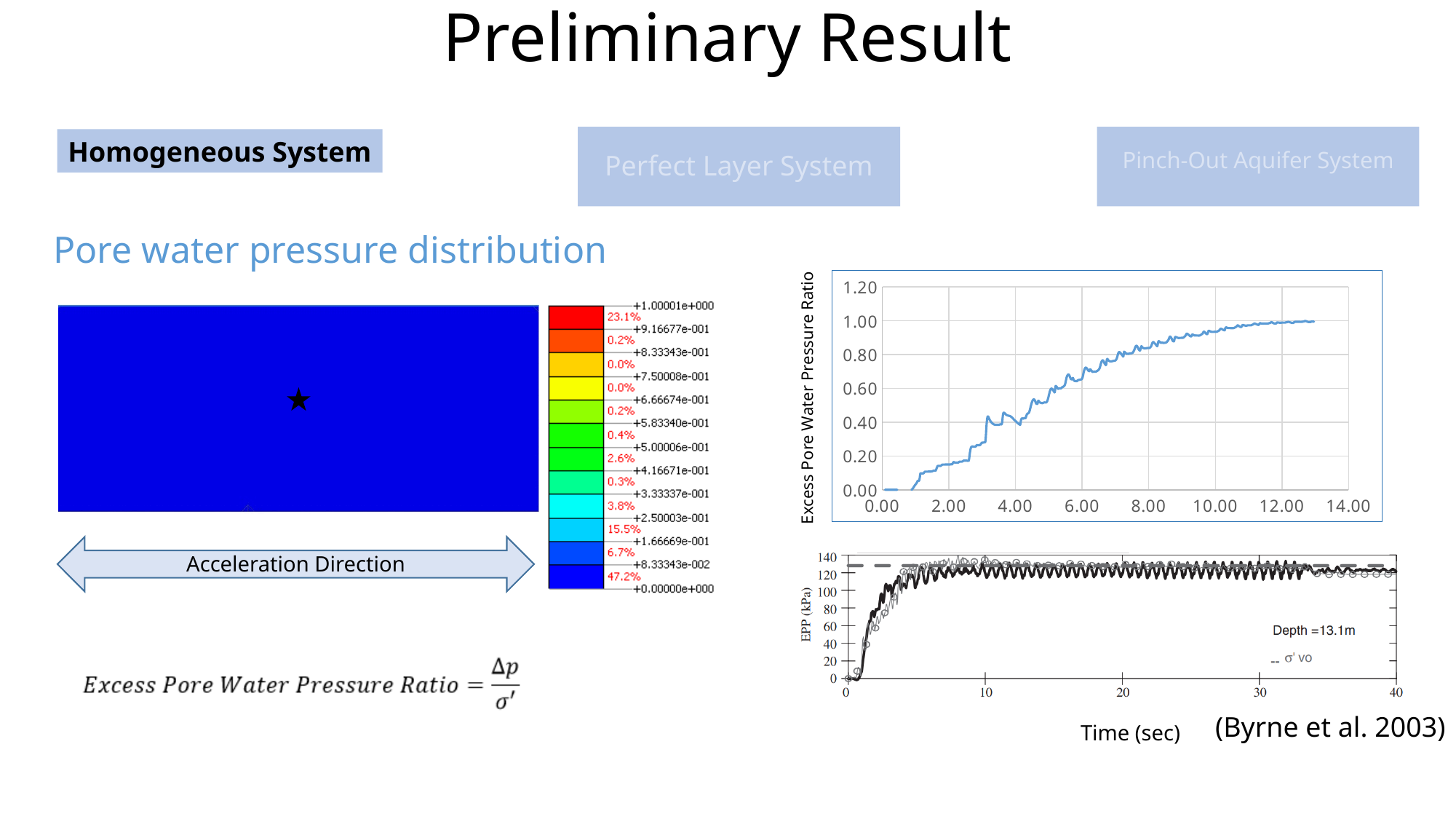
In the lower-right EPP chart (Byrne et al. 2003), is the EPP value at 1 second greater or less than 60 kPa? less In the lower-right EPP chart (Byrne et al. 2003), is the EPP value at 20 seconds greater or less than 100 kPa? greater What type of chart is the upper-right chart of Excess Pore Water Pressure Ratio? line chart In the upper-right Excess Pore Water Pressure Ratio chart, what is the highest value shown on the vertical axis? 1.20 In the upper-right Excess Pore Water Pressure Ratio chart, is the value at 10.00 greater or less than 0.80? greater In the upper-right Excess Pore Water Pressure Ratio chart, what is the largest tick value on the horizontal axis? 14.00 In the lower-right EPP chart (Byrne et al. 2003), what depth is stated in the chart annotation? 13.1m In the upper-right Excess Pore Water Pressure Ratio chart, does the value generally rise or fall as time increases? rise In the colour legend next to the pore water pressure distribution plot, what percentage is printed beside the lowest (dark blue) band? 47.2% How many data series are plotted in the upper-right Excess Pore Water Pressure Ratio chart? 1